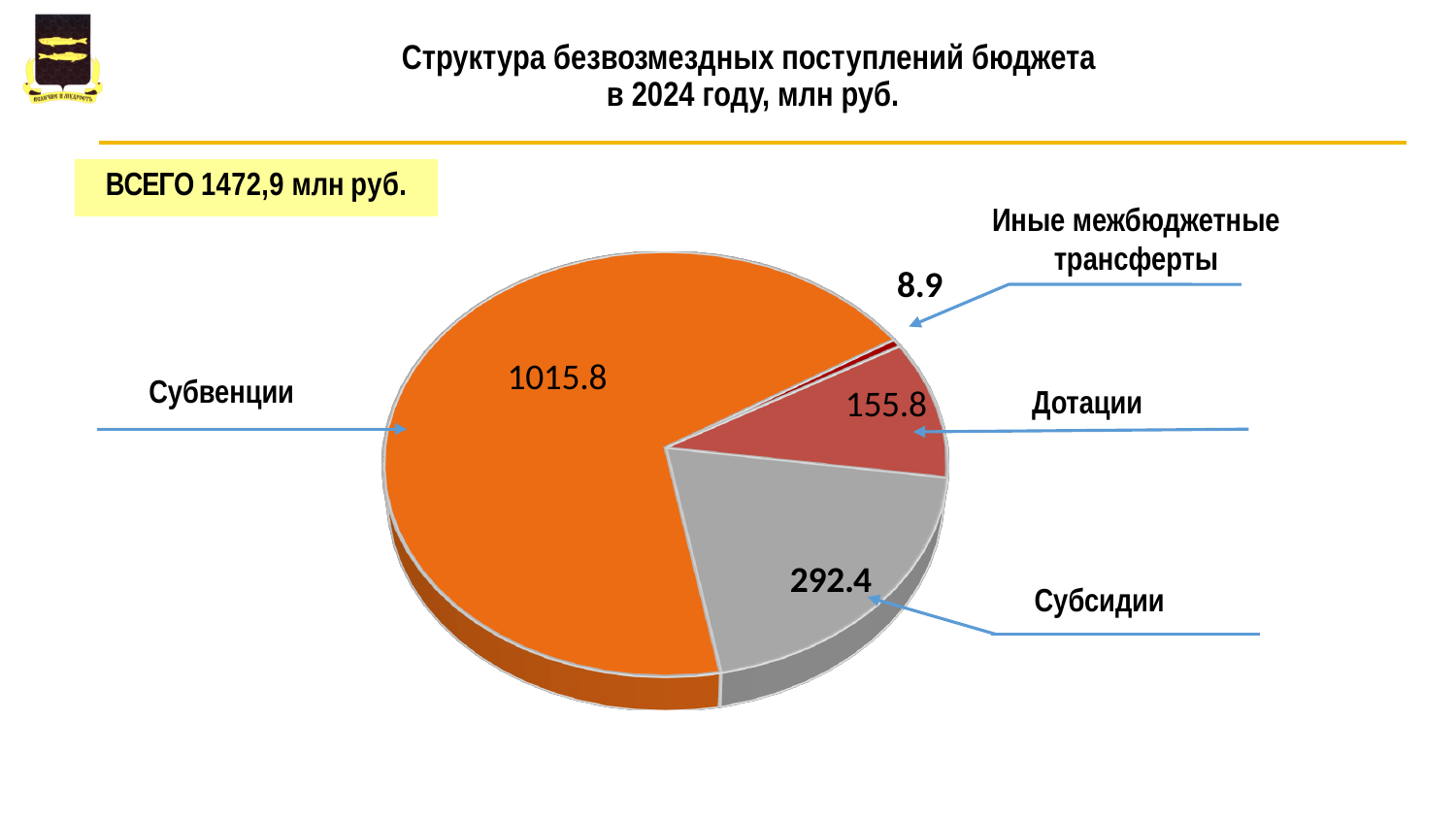
What is the value for Субвенции? 1015.8 Which is larger, the value for Дотации or the value for Субсидии? Субсидии How many slices does the pie chart have? 4 Which category has the largest slice of the pie? Субвенции What kind of chart is shown on the slide? Pie chart Which category has the smallest slice of the pie? Иные межбюджетные трансферты What is the difference between the values for Субсидии and Дотации? 136.6 What total amount is stated on the slide for all gratuitous receipts (ВСЕГО)? 1472,9 млн руб. What is the value for Дотации? 155.8 What is the value for Субсидии? 292.4 What is the difference between the values for Субвенции and Субсидии? 723.4 What is the value for Иные межбюджетные трансферты? 8.9